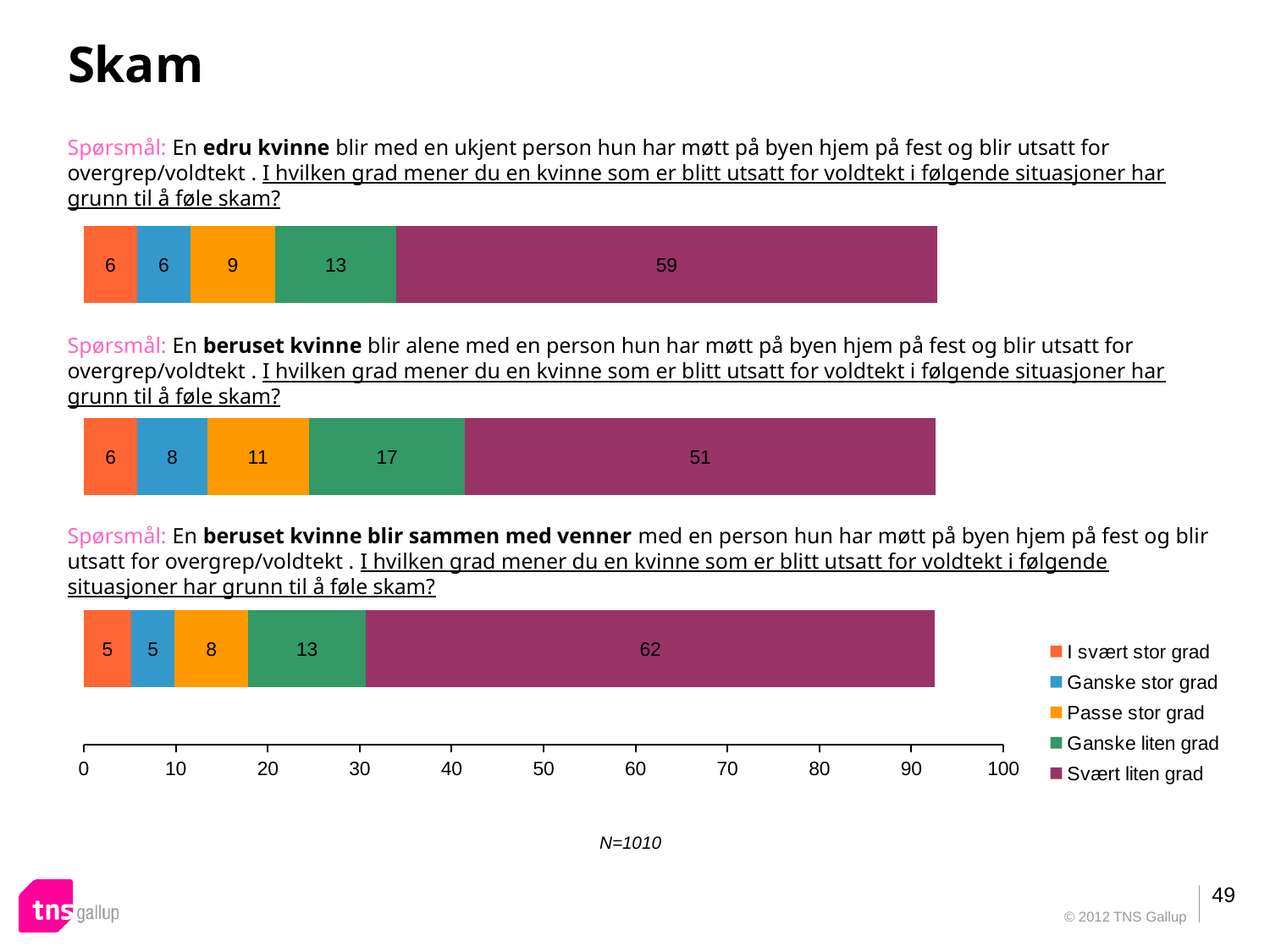
How many series does the legend list? 5 In the middle chart (beruset kvinne blir alene), what is the value for 'Ganske liten grad'? 17 In the bottom chart (beruset kvinne blir sammen med venner), which category has the highest value? Svært liten grad What is the difference between the 'Svært liten grad' value in the bottom chart (62) and in the middle chart (51)? 11 In the top chart (edru kvinne), what is the value for 'Svært liten grad'? 59 In the middle chart (beruset kvinne blir alene), which category has the lowest value? I svært stor grad Which legend entry is shown in purple? Svært liten grad In the middle chart (beruset kvinne blir alene), what is the value for 'Passe stor grad'? 11 In the bottom chart (beruset kvinne blir sammen med venner), what is the value for 'I svært stor grad'? 5 Which is larger: 'Ganske liten grad' in the middle chart or 'Ganske liten grad' in the top chart? Middle chart (17) What kind of chart is used on this slide? Stacked bar chart What is the total of the stacked bar in the top chart (edru kvinne)? 93